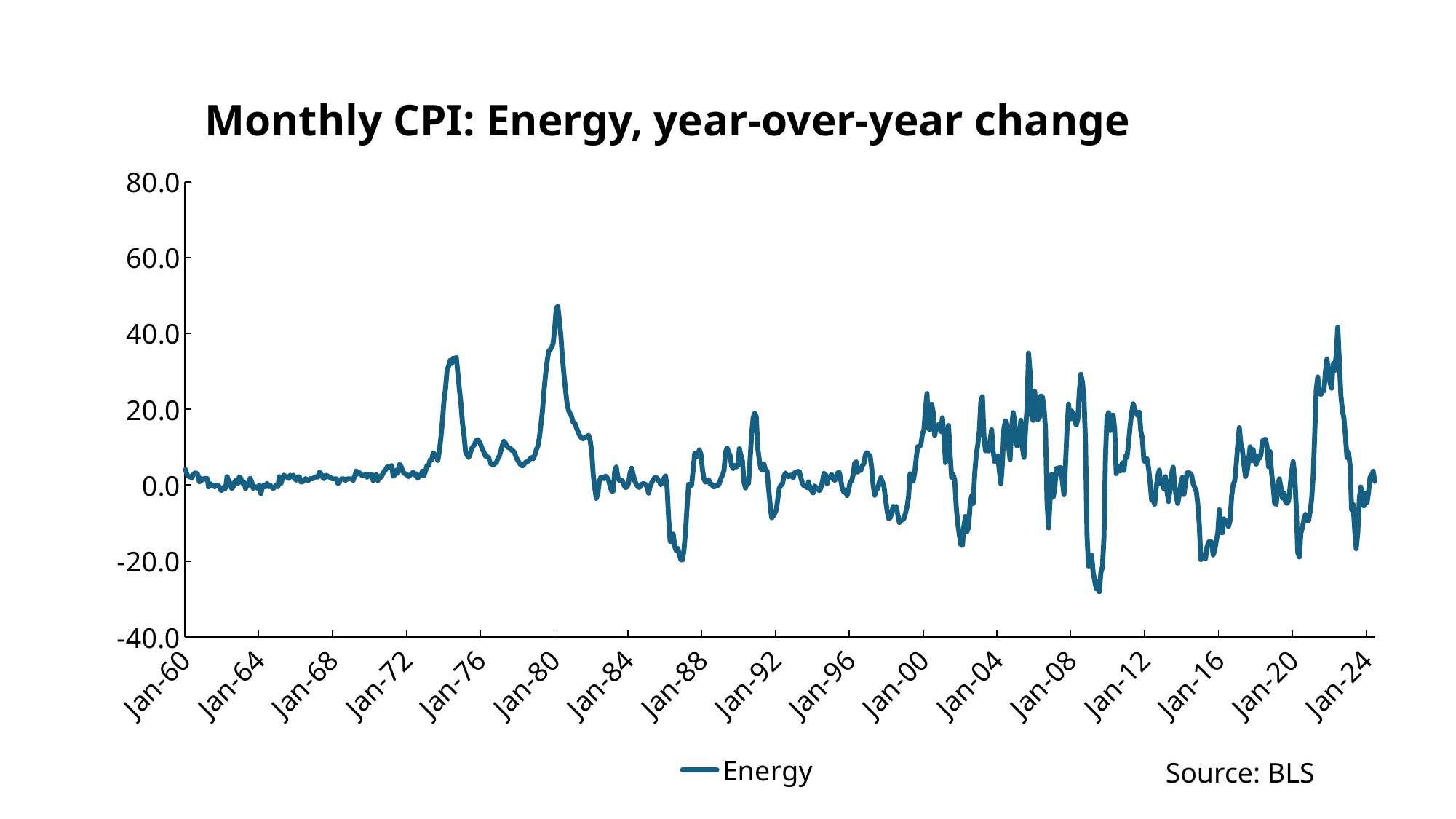
Around which x-axis label does the Energy line reach its lowest point? Jan-08 What kind of chart is shown on the slide? Line chart Does the Energy line rise or fall between Jan-80 and Jan-84? Fall What is the title of the chart? Monthly CPI: Energy, year-over-year change What is the name of the series shown in the legend? Energy Is the lowest value of the Energy line, just after Jan-08, greater or less than -20.0? less Around which x-axis label does the Energy line reach its highest peak? Jan-80 Is the peak of the Energy line between Jan-20 and Jan-24 greater or less than 20.0? greater Which is higher: the peak of the Energy line near Jan-80 or the peak between Jan-20 and Jan-24? The peak near Jan-80 How many labelled tick marks are on the x axis? 17 How many series does the legend list? 1 Is the peak value of the Energy line near Jan-80 greater or less than 40.0? greater